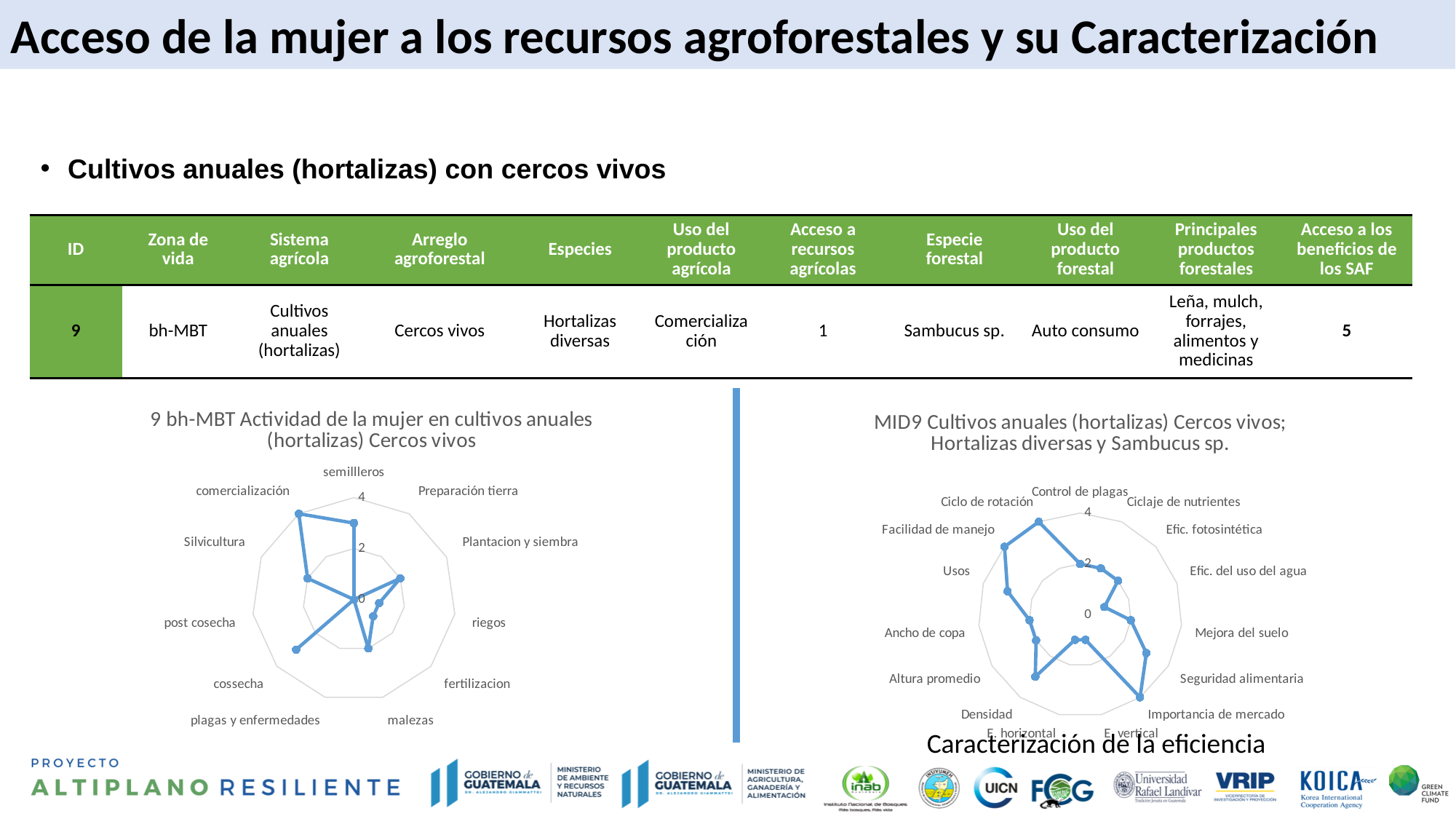
In the left chart, is the value for 'cossecha' greater or less than 2? greater How many categories (axes) does the right radar chart have? 15 What is the highest tick value shown on the axis of the left radar chart? 4 In the right chart, is the value for 'Densidad' greater or less than 2? greater In the left chart, is the value for 'Preparación tierra' greater or less than 2? less What kind of chart is the right chart titled 'MID9 Cultivos anuales (hortalizas) Cercos vivos; Hortalizas diversas y Sambucus sp.'? Radar chart How many categories (axes) does the left radar chart have? 11 What kind of chart is the left chart titled '9 bh-MBT Actividad de la mujer en cultivos anuales (hortalizas) Cercos vivos'? Radar chart